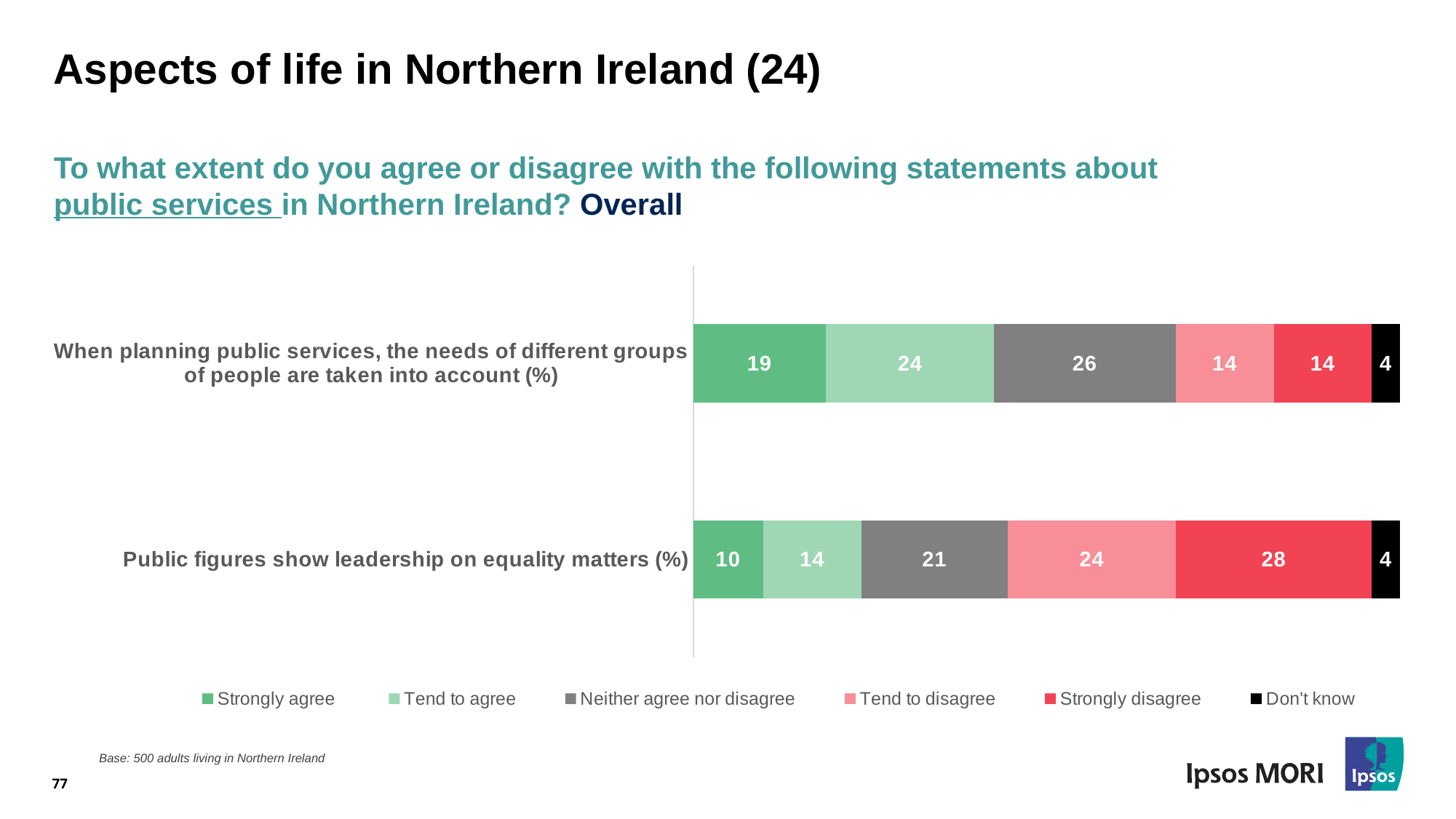
What kind of chart is shown on the slide? Stacked bar chart What percentage neither agree nor disagree that public figures show leadership on equality matters? 21 What is the total of the 'Strongly agree' and 'Tend to agree' segments for the statement 'Public figures show leadership on equality matters'? 24 Which response category has the smallest share for the statement 'Public figures show leadership on equality matters'? Don't know How many series does the legend list? 6 What percentage strongly disagree that public figures show leadership on equality matters? 28 What percentage strongly agree that when planning public services, the needs of different groups of people are taken into account? 19 Which response category has the largest share for the statement 'When planning public services, the needs of different groups of people are taken into account'? Neither agree nor disagree Which statement has the higher 'Tend to disagree' percentage? Public figures show leadership on equality matters What percentage tend to agree that when planning public services, the needs of different groups of people are taken into account? 24 What is the difference between the 'Strongly disagree' percentages for the two statements? 14 How many statements are shown in the chart? 2